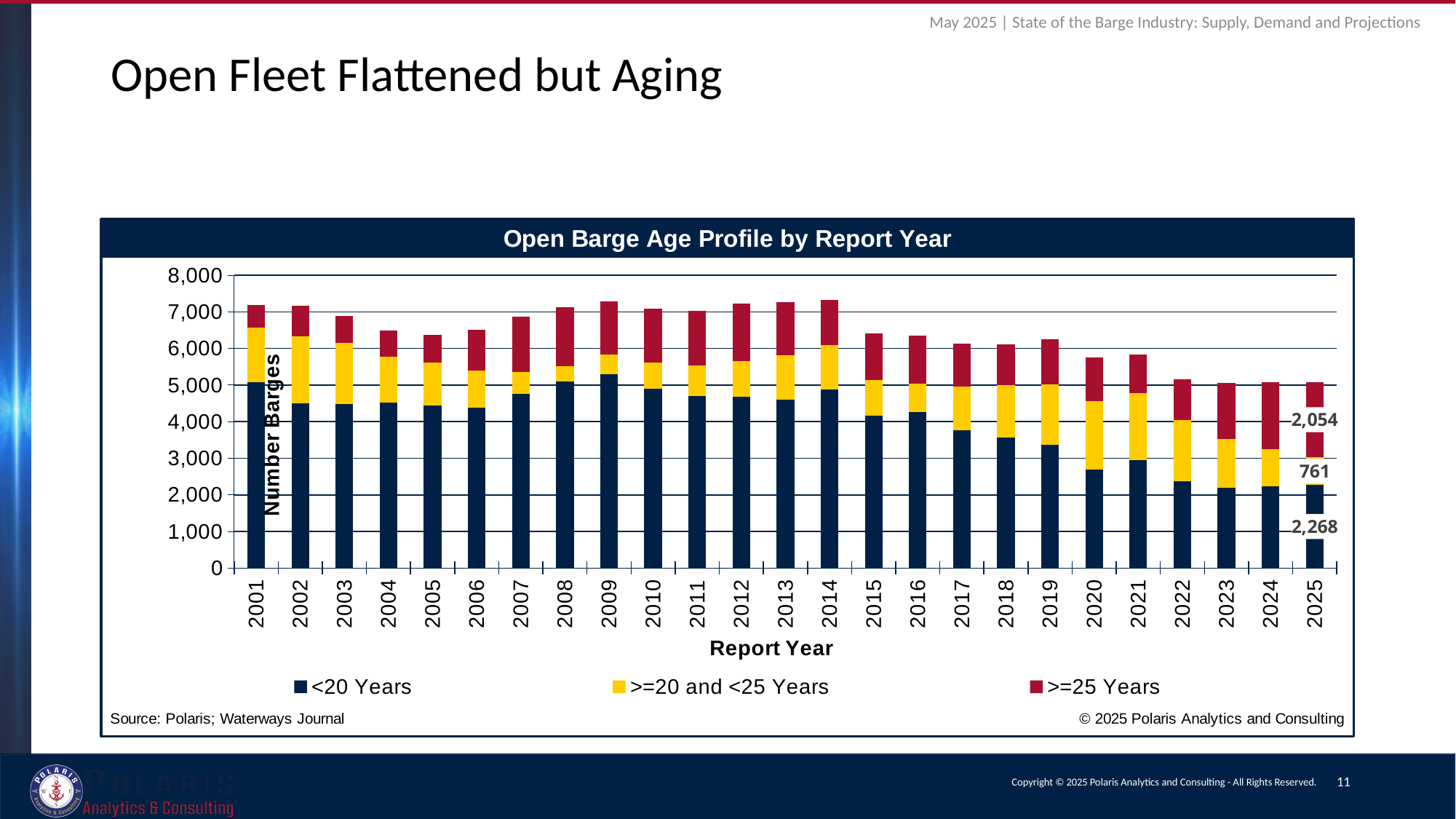
Does the <20 Years segment rise or fall from 2014 to 2025? fall What is the value for >=20 and <25 Years in 2025? 761 How many series does the legend list? 3 What kind of chart is shown on the slide? bar chart What is the difference between the <20 Years and >=25 Years values in 2025? 214 Is the <20 Years value for 2009 greater or less than 5,000? greater In 2025, which is larger: the <20 Years segment or the >=25 Years segment? <20 Years How many report years are shown on the x axis? 25 What is the value for >=25 Years in 2025? 2,054 What is the total number of barges in the 2025 stacked bar? 5,083 Is the total bar height for 2020 greater or less than 6,000? less What is the value for <20 Years in 2025? 2,268